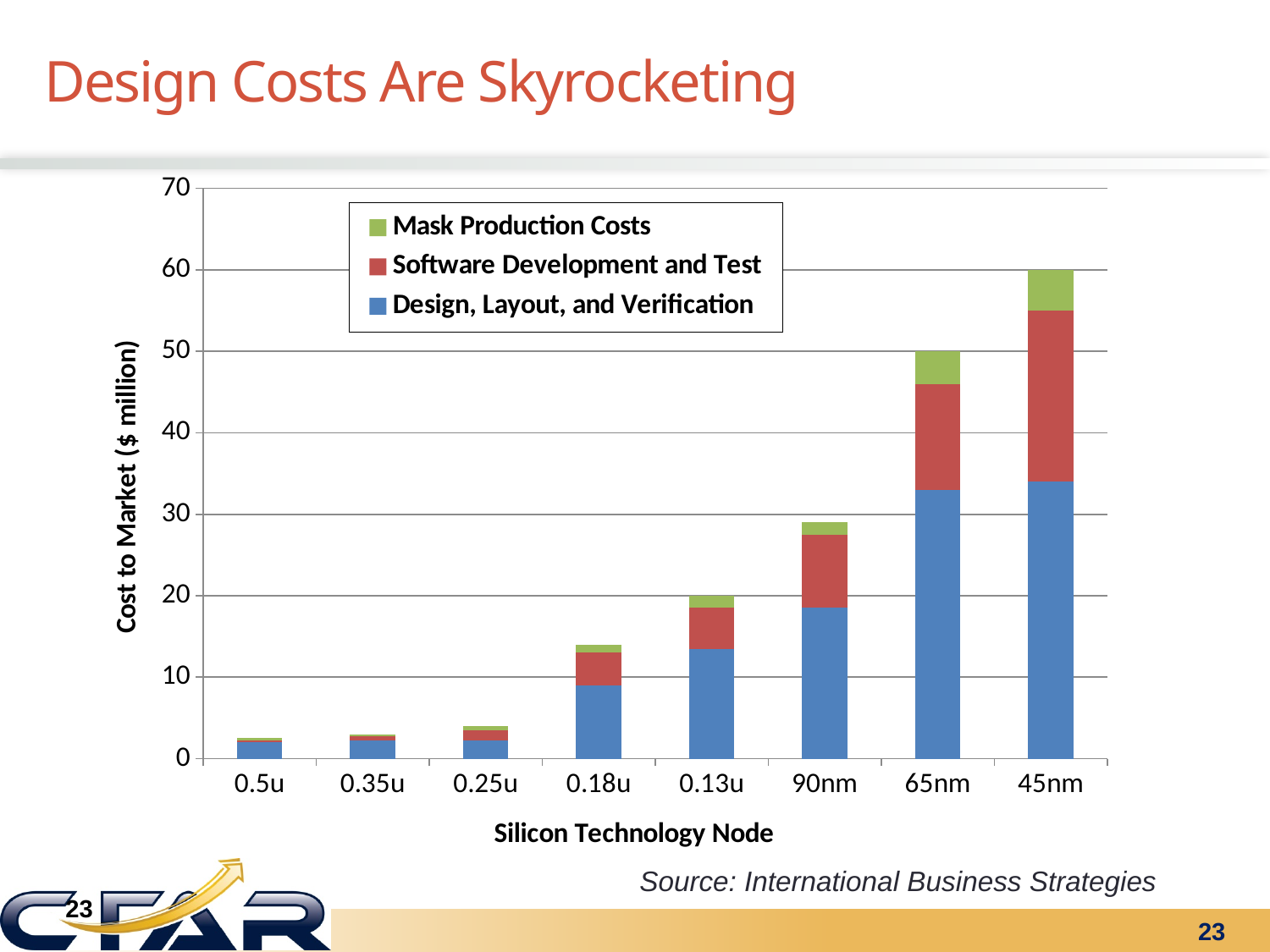
Which silicon technology node has the highest total cost to market? 45nm Which has a larger total cost to market, 65nm or 90nm? 65nm What is the label of the y axis? Cost to Market ($ million) What is the total cost to market for the 45nm bar? 60 How many silicon technology nodes are shown on the x axis? 8 Is the Design, Layout, and Verification value for 65nm greater or less than 30? greater What kind of chart is shown on the slide? Stacked bar chart Is the total cost to market for 0.18u greater or less than 10? greater Do the total costs rise or fall as the technology node moves from 0.5u to 45nm? rise Is the total cost to market for 90nm greater or less than 30? less What is the label of the x axis? Silicon Technology Node How many series does the legend list? 3